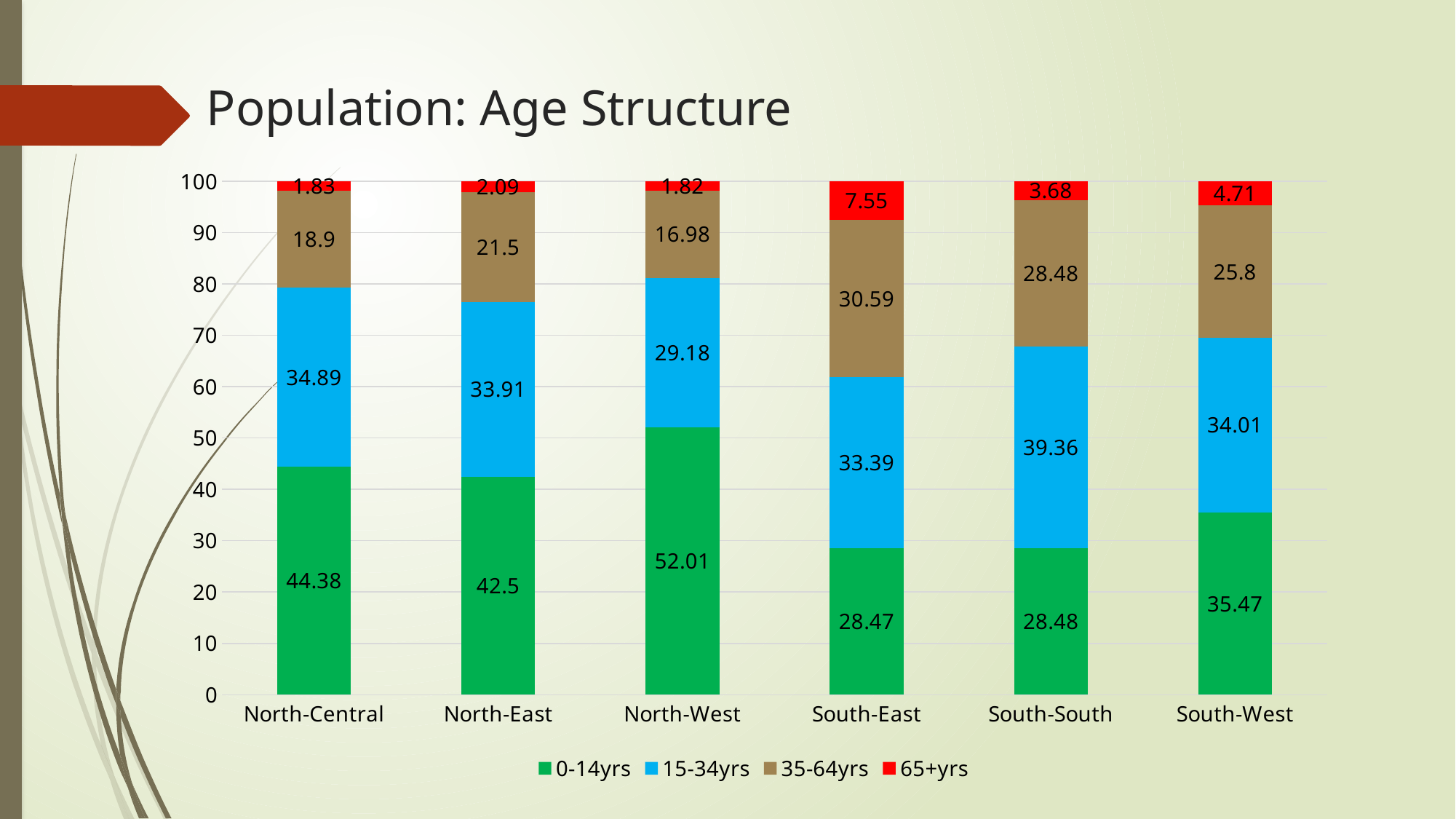
Which region has the highest value for 65+yrs? South-East How many regions are shown on the x axis? 6 What is the total of the stacked bar for North-Central? 100 What is the value for 65+yrs in South-West? 4.71 Which is larger, the 15-34yrs value for South-South or for South-West? South-South What kind of chart is shown on the slide? Stacked bar chart What is the value for 0-14yrs in North-West? 52.01 How many series does the legend list? 4 Which region has the highest value for 0-14yrs? North-West Which region has the lowest value for 35-64yrs? North-West What is the value for 35-64yrs in South-East? 30.59 What is the difference between the 0-14yrs values for North-Central and North-East? 1.88